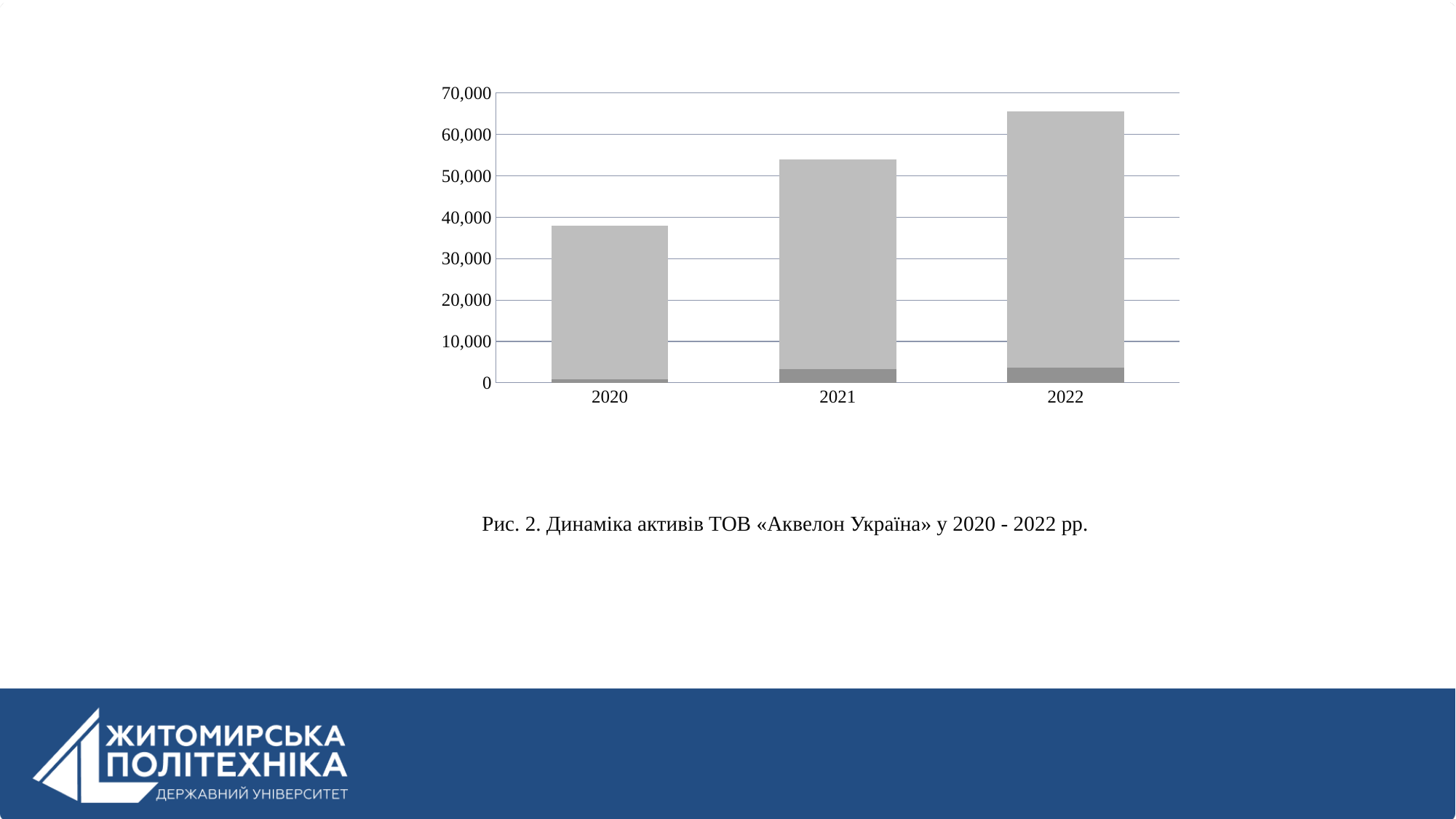
How many years are shown on the x axis of the chart? 3 What kind of chart is shown on the slide? bar chart Is the total bar height for 2022 greater or less than 60,000? greater Is the total bar height for 2020 greater or less than 40,000? less Is the total bar height for 2021 greater or less than 50,000? greater Which year has the shortest bar in the chart? 2020 Which year has the tallest bar in the chart? 2022 Which bar is taller, 2020 or 2021? 2021 What is the caption printed below the chart? Рис. 2. Динаміка активів ТОВ «Аквелон Україна» у 2020 - 2022 рр. Do the bar heights rise or fall from 2020 to 2022? rise